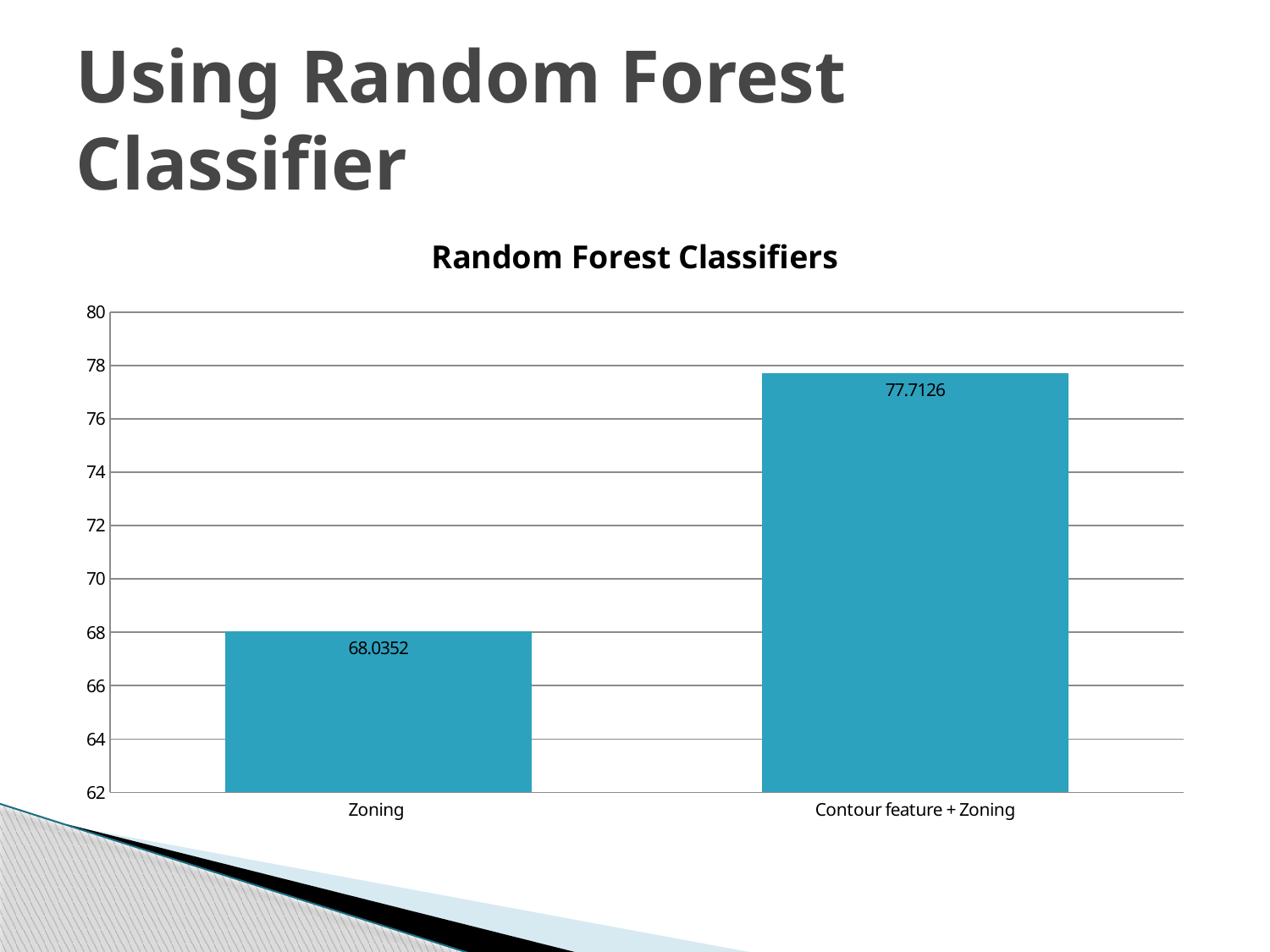
Do the values rise or fall from left to right along the x axis? rise Which is larger, the value for Zoning or the value for Contour feature + Zoning? Contour feature + Zoning How many categories are shown on the x axis? 2 Is the value for Zoning greater or less than 70? less Which category has the lowest value? Zoning Which category has the highest value? Contour feature + Zoning What is the difference between the values for Contour feature + Zoning and Zoning? 9.6774 What is the value for Zoning? 68.0352 Is the value for Contour feature + Zoning greater or less than 76? greater What kind of chart is shown on the slide? bar chart What is the value for Contour feature + Zoning? 77.7126 What is the title of the chart? Random Forest Classifiers